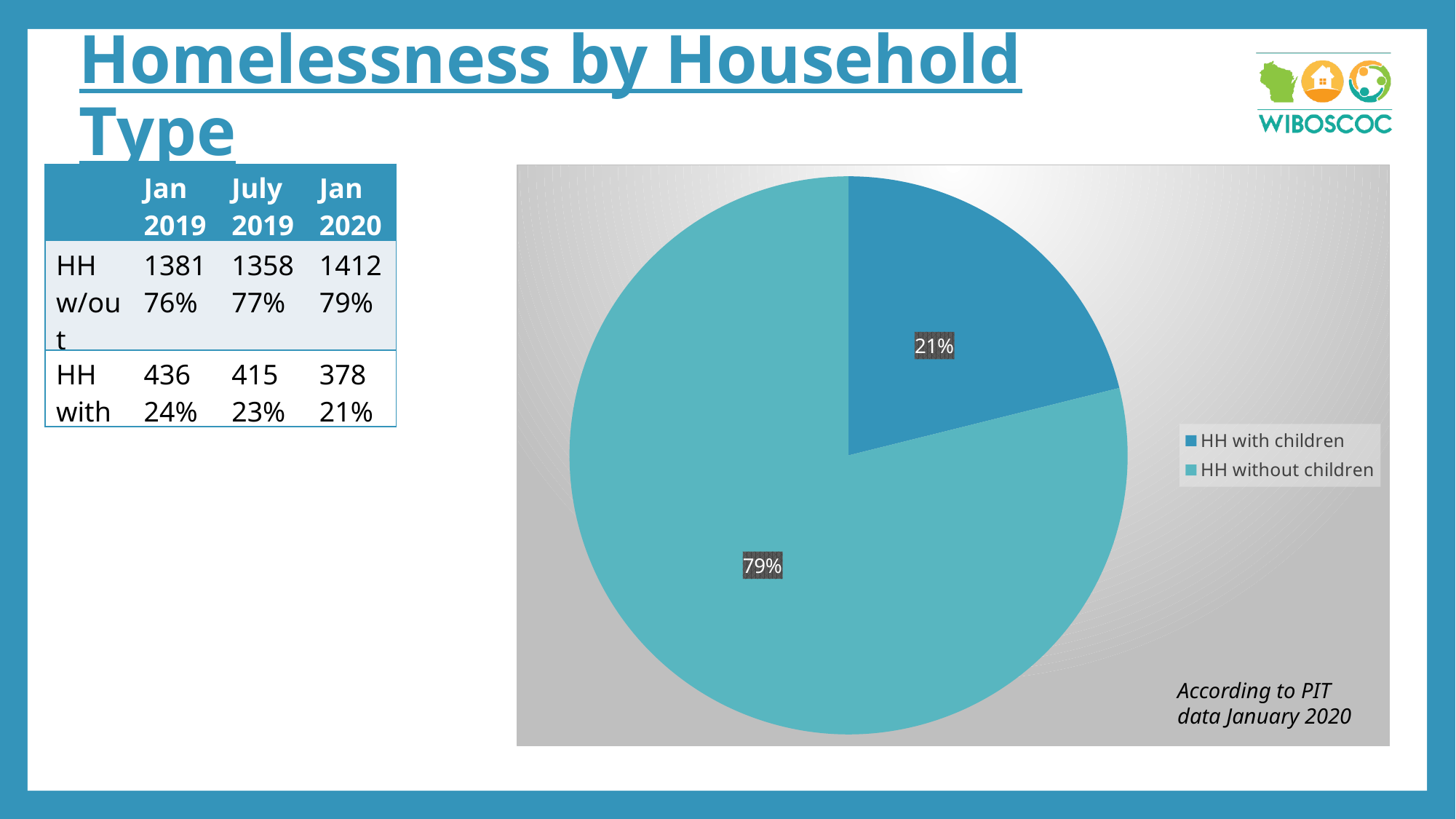
Which slice of the pie chart is the smallest? HH with children Which slice of the pie chart is the largest? HH without children Which is larger in the pie chart, HH with children or HH without children? HH without children According to the note on the chart, what data source and date does the pie chart use? PIT data January 2020 How many slices does the pie chart have? 2 What share of the pie chart is labelled for HH without children? 79% Is the share for HH without children greater or less than 50%? greater What kind of chart is shown on the slide? pie chart What is the difference in percentage points between the HH without children slice and the HH with children slice? 58% Which legend entry is shown in the darker blue colour? HH with children How many entries does the pie chart's legend list? 2 What share of the pie chart is labelled for HH with children? 21%